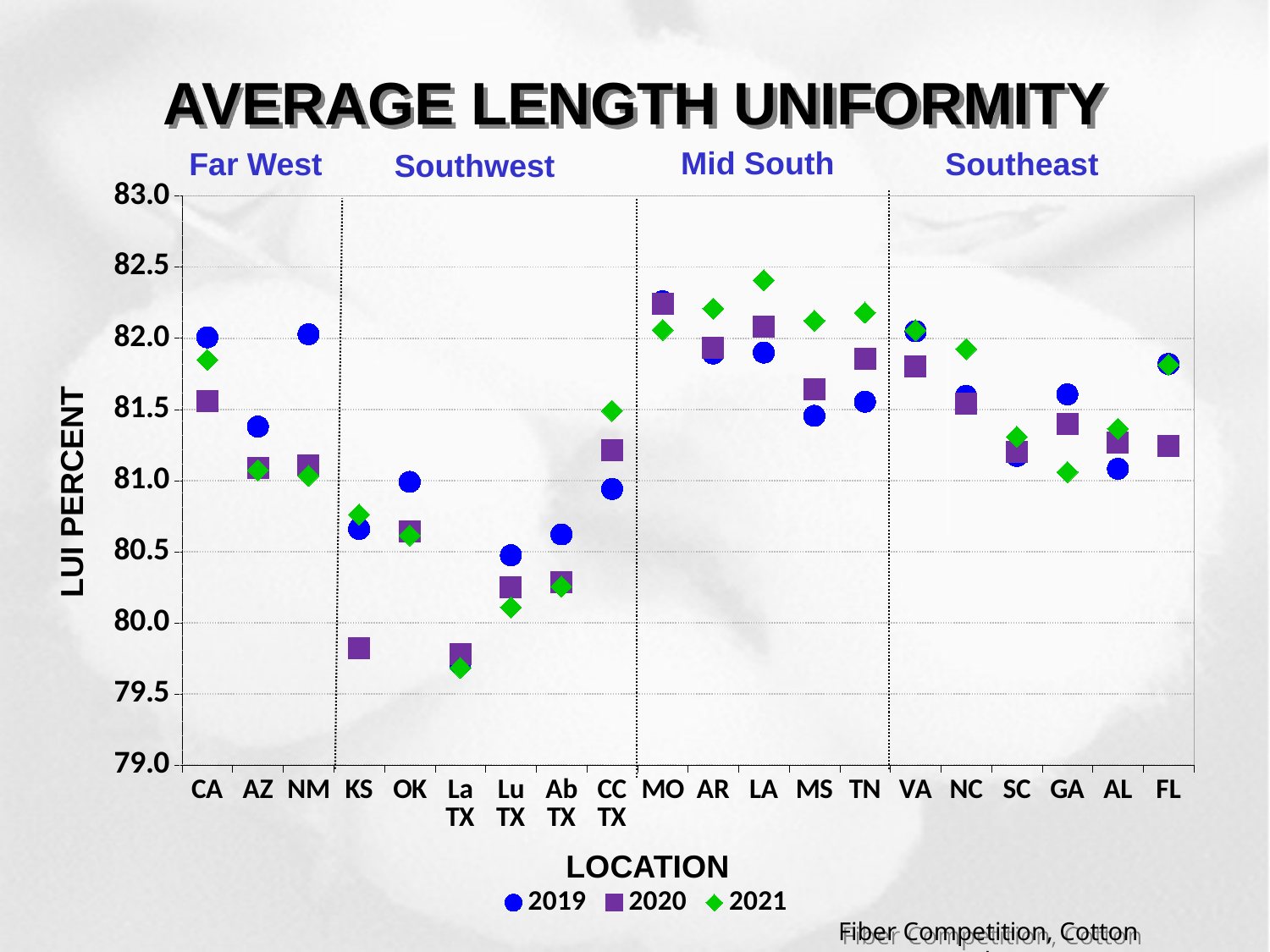
Which location has the highest 2019 value? MO Which location has the highest 2021 value? LA Which region labels are shown above the chart? Far West, Southwest, Mid South, Southeast Is the 2019 value for CA greater or less than 81.5? greater How many series does the legend list? 3 Is the 2021 value for LA greater or less than 82.0? greater Which location has the lowest 2021 value? La TX How many locations are shown along the x axis? 20 Which location has the lowest 2019 value? La TX Is the 2020 value for KS greater or less than 80.0? less For CA, which is larger, the 2019 value or the 2020 value? 2019 What kind of chart is shown on the slide? scatter chart